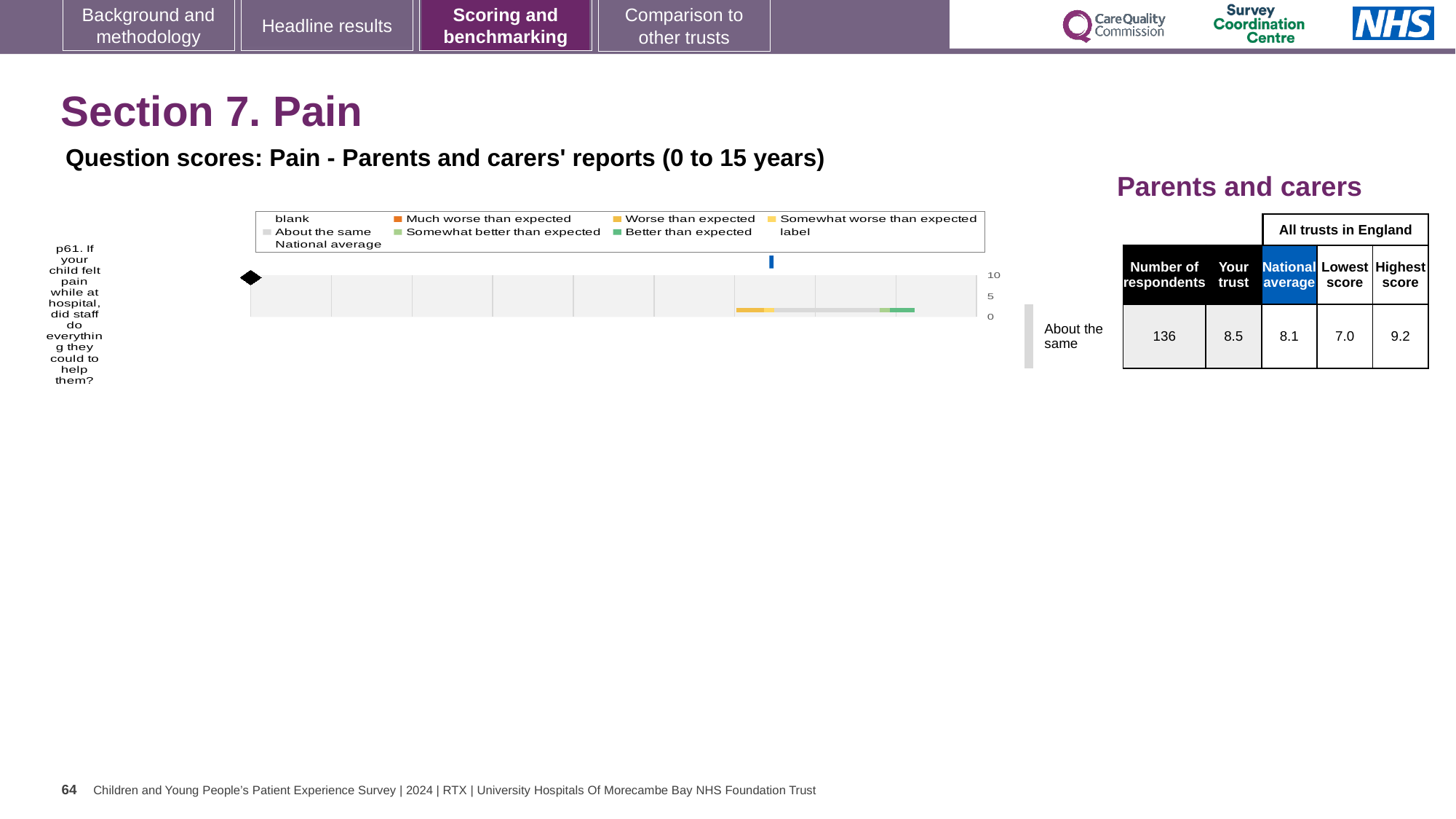
What is the highest tick value shown on the chart's score axis? 10 What colour does the legend use for 'Better than expected'? green What is the difference between the highest and lowest trust scores for question p61? 2.2 Which is larger for question p61: the 'Your trust' score or the national average? Your trust What is the lowest score among all trusts in England for question p61? 7.0 What colour does the legend use for 'Much worse than expected'? orange What is the highest score among all trusts in England for question p61? 9.2 What is the 'Your trust' score for question p61 about staff helping with pain? 8.5 What is the national average score for question p61? 8.1 How many survey questions (categories) are plotted in the chart? 1 How many respondents answered question p61? 136 What kind of chart is shown on the slide? bar chart